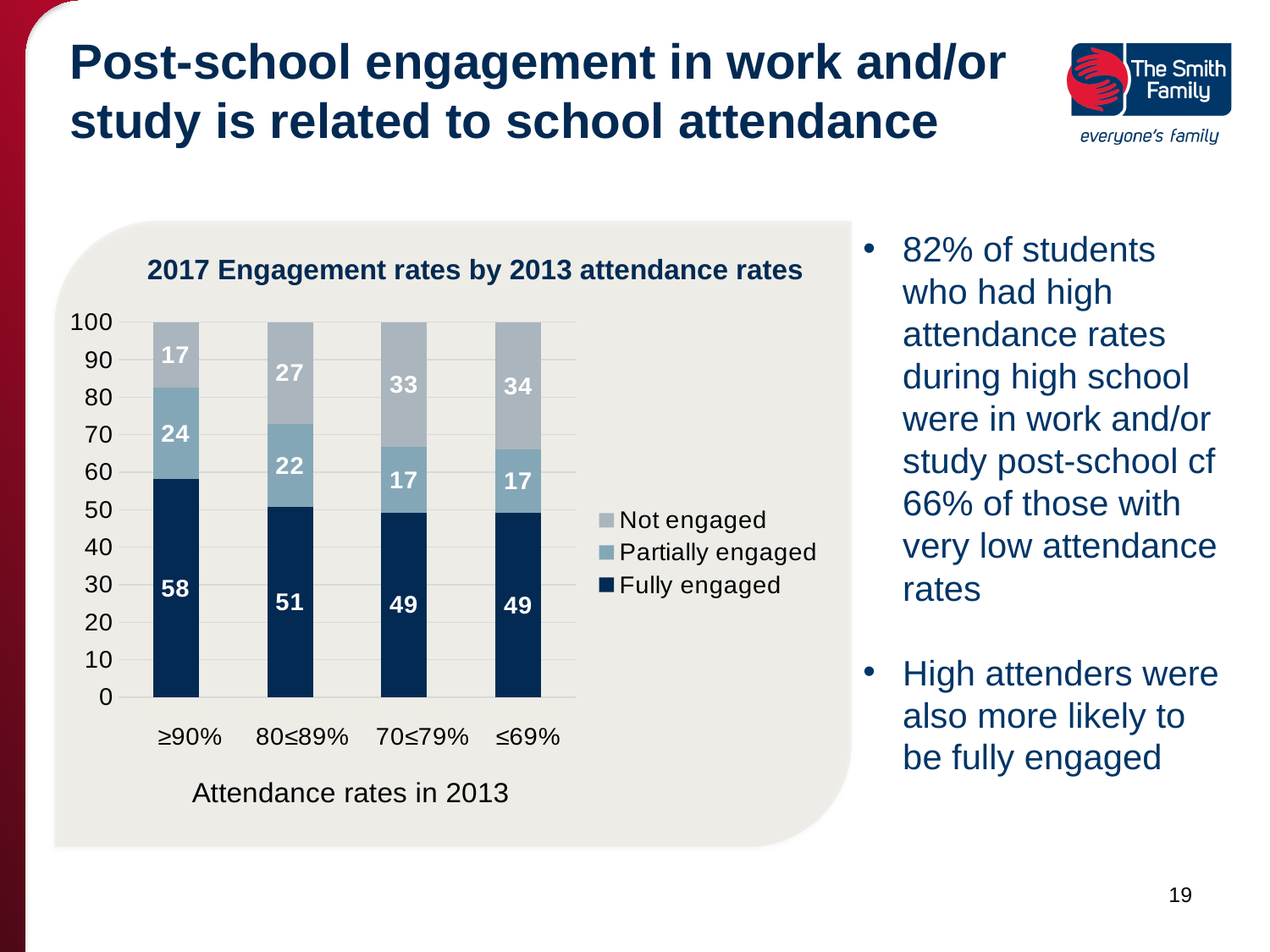
How many series does the legend list? 3 What is the difference between the Fully engaged values for the ≥90% and 80≤89% groups? 7 What is the Partially engaged value for the 80≤89% attendance group? 22 How many attendance rate categories are shown on the x axis? 4 Which attendance group has the lowest Not engaged value? ≥90% What is the difference between the Not engaged values for the ≤69% and ≥90% groups? 17 What is the title of the chart? 2017 Engagement rates by 2013 attendance rates What kind of chart is shown on the slide? Stacked bar chart What is the Fully engaged value for the ≥90% attendance group? 58 Which attendance group has the highest Fully engaged value? ≥90% What is the Not engaged value for the ≤69% attendance group? 34 Which is larger: the Partially engaged value for ≥90% or for 70≤79%? ≥90%